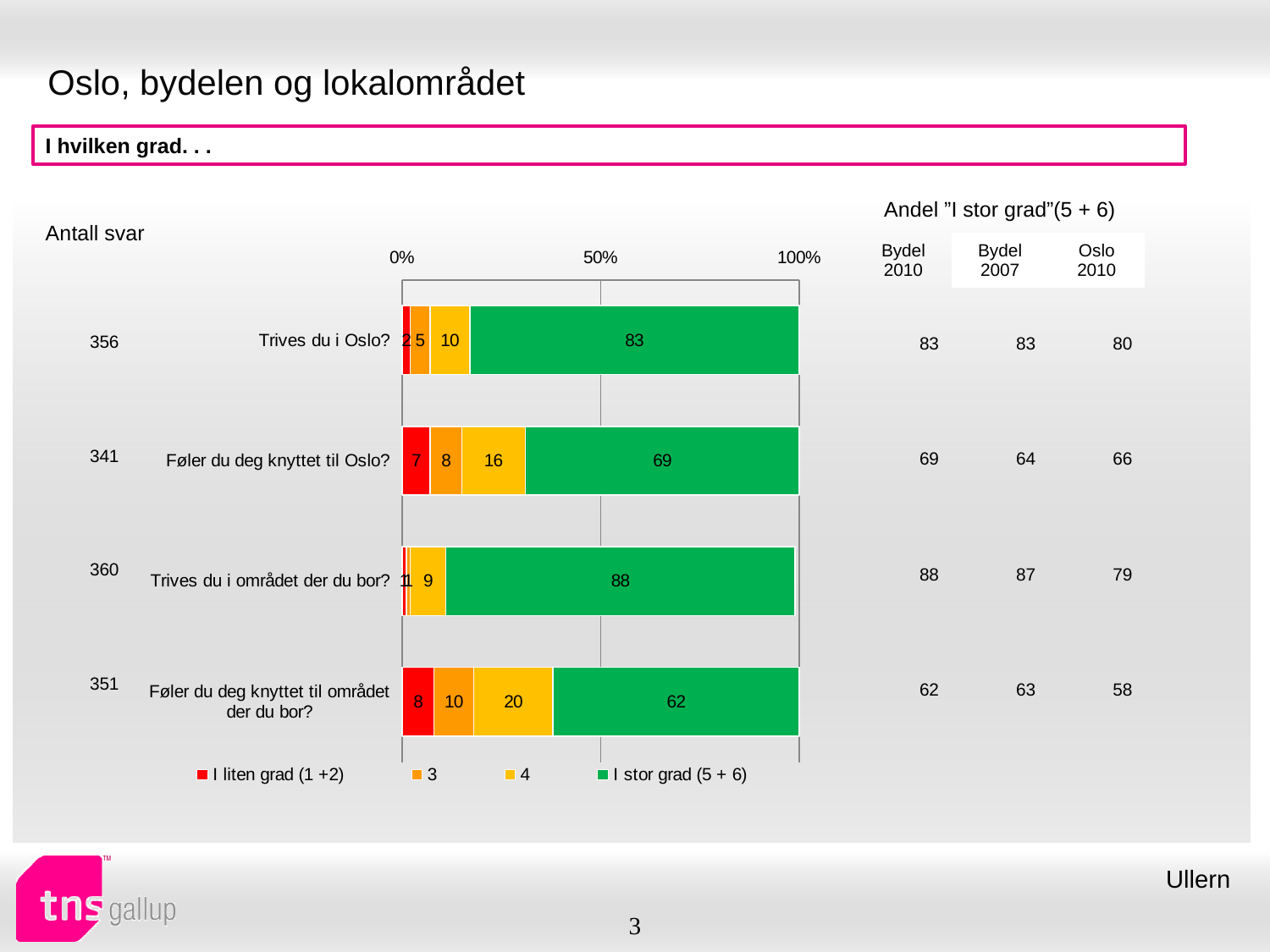
What is the value of "I stor grad (5 + 6)" for "Trives du i Oslo?"? 83 How many questions (categories) are plotted in the chart? 4 What is the difference between the "I stor grad (5 + 6)" values for "Trives du i Oslo?" and "Føler du deg knyttet til Oslo?"? 14 What is the value of "I liten grad (1 +2)" for "Føler du deg knyttet til Oslo?"? 7 Which is larger: the series "4" value for "Føler du deg knyttet til Oslo?" or for "Trives du i Oslo?"? Føler du deg knyttet til Oslo? Which question has the lowest value for "I stor grad (5 + 6)"? Føler du deg knyttet til området der du bor? How many series does the chart legend list? 4 What is the value of series "4" for "Føler du deg knyttet til området der du bor?"? 20 What is the value of "I stor grad (5 + 6)" for "Føler du deg knyttet til Oslo?"? 69 Which question has the highest value for "I stor grad (5 + 6)"? Trives du i området der du bor? What kind of chart is shown on the slide? Stacked bar chart What is the label of the green series in the legend? I stor grad (5 + 6)